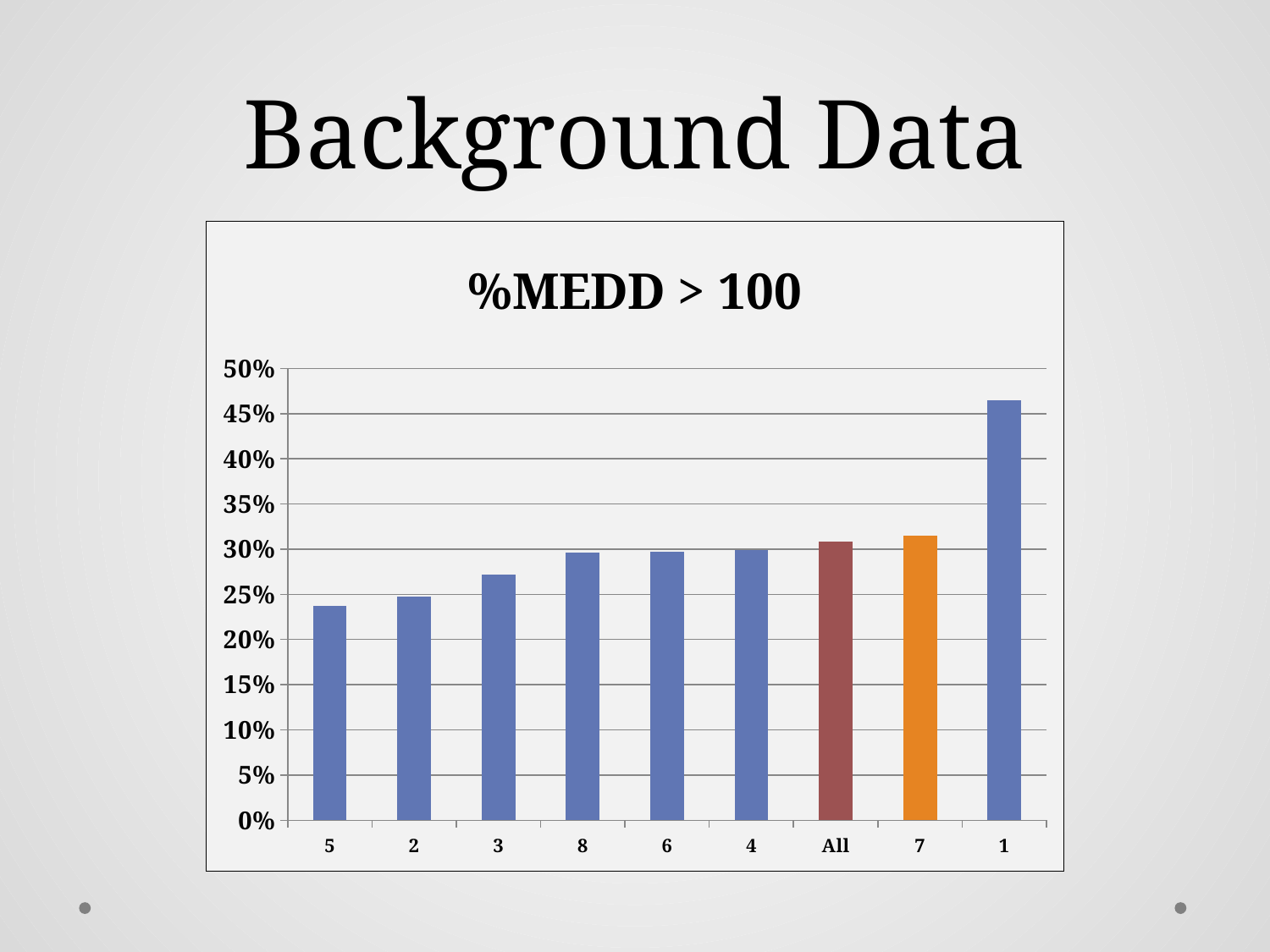
Is the value for category 1 greater or less than 45%? greater Which is larger, the value for category 1 or the value for category 5? 1 Do the bar values generally rise or fall from left to right along the x axis? rise Which category has the lowest value in the chart? 5 Is the value for category 7 greater or less than 30%? greater How many bars are plotted in the chart? 9 What is the title of the chart? %MEDD > 100 Is the value for category 3 greater or less than 25%? greater What type of chart is shown on the slide? bar chart Which category has the highest value in the chart? 1 Which is larger, the value for category 7 or the value for category 2? 7